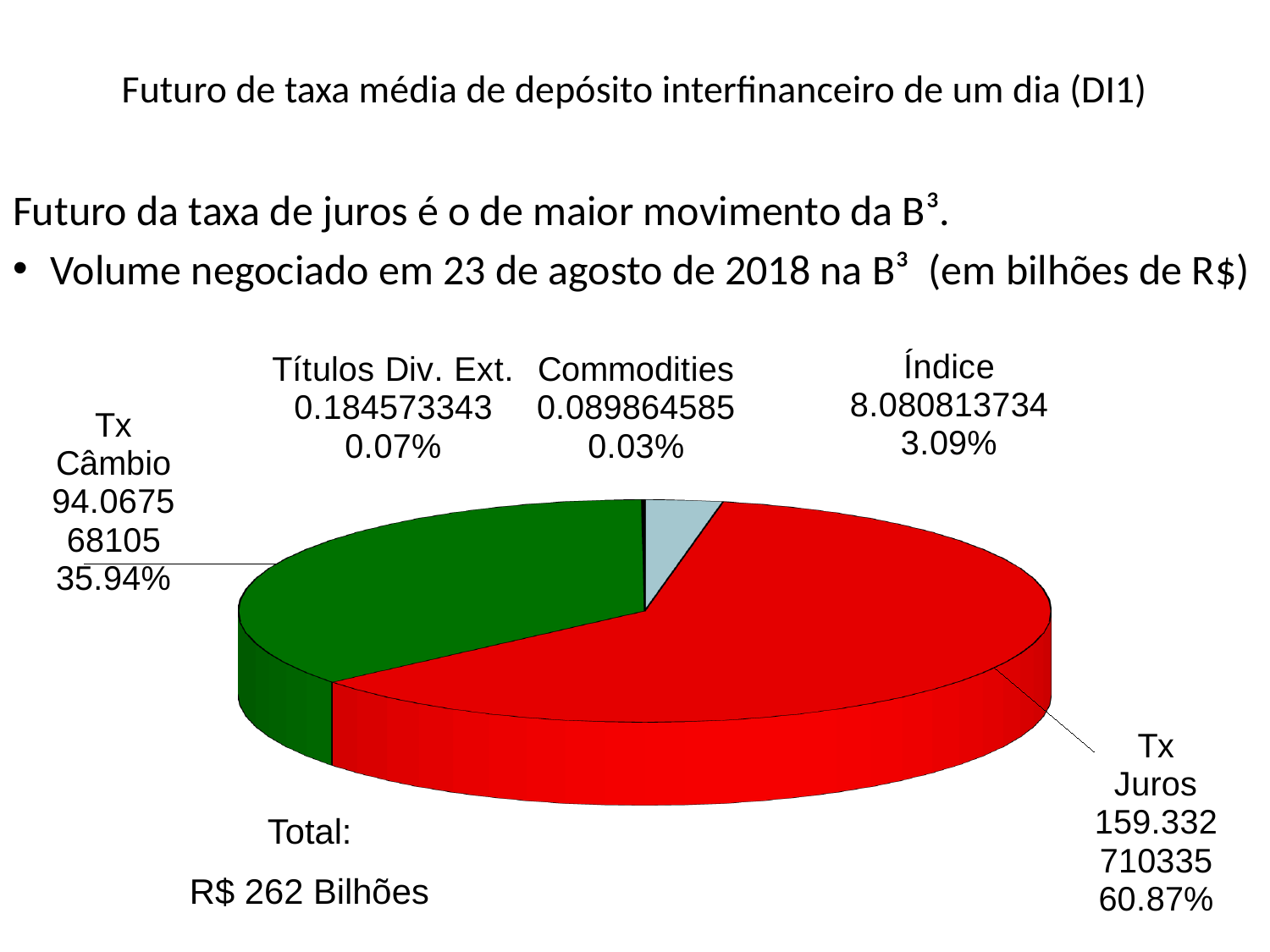
What share of the pie does Tx Câmbio represent? 35.94% How many categories does the pie chart show? 5 Which category has the smallest slice of the pie? Commodities What share of the pie does Índice represent? 3.09% What share of the pie does Tx Juros represent? 60.87% What is the value shown for Índice? 8.080813734 Which category has the largest slice of the pie? Tx Juros What total is stated below the pie chart? R$ 262 Bilhões What kind of chart is shown on the slide? pie chart Which is larger, the share for Tx Câmbio or the share for Índice? Tx Câmbio What is the value shown for Títulos Div. Ext.? 0.184573343 What is the value shown for Commodities? 0.089864585